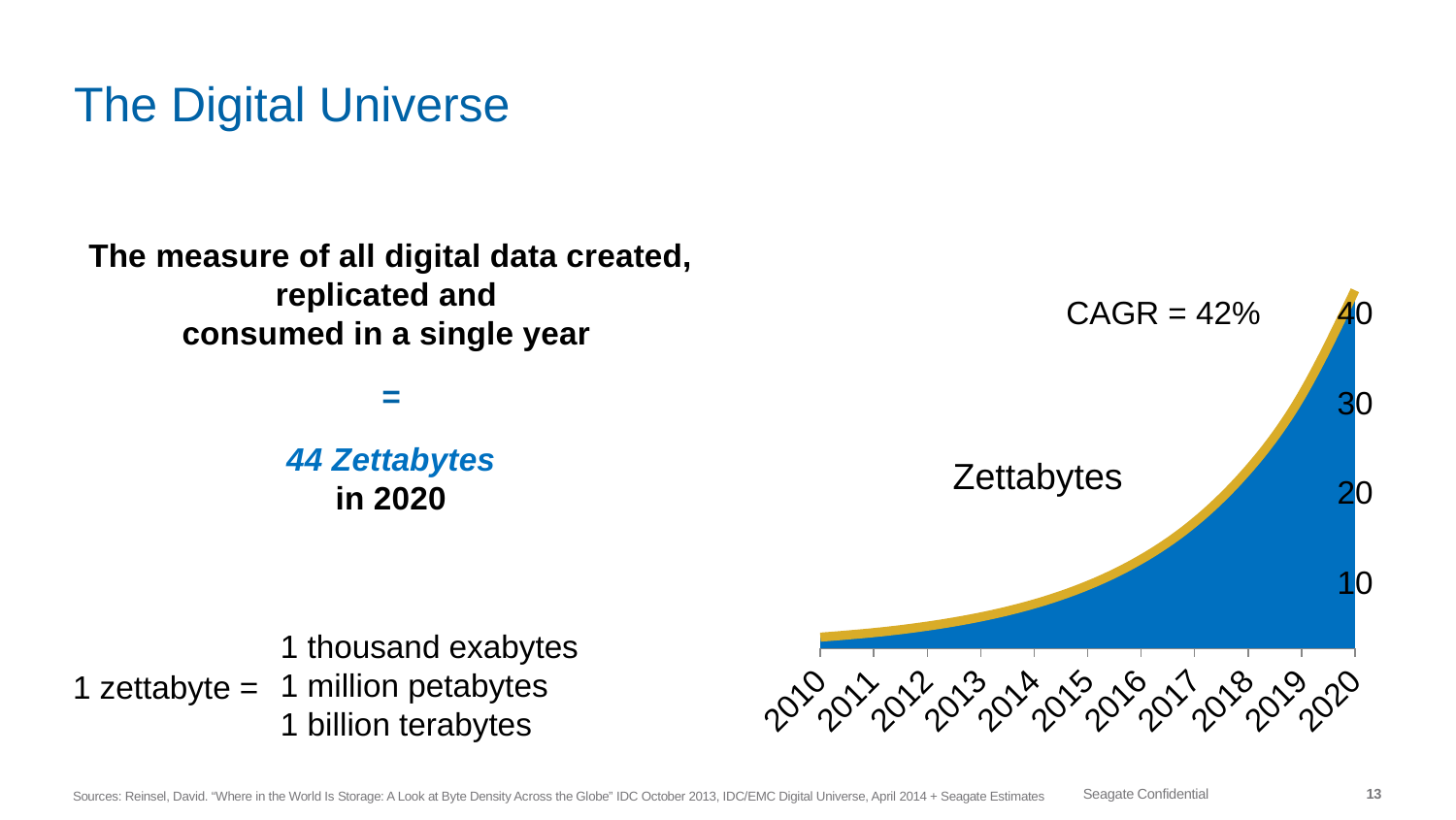
How many years are shown on the x axis of the chart? 11 What CAGR is stated on the chart? 42% Is the value for 2020 greater or less than 30? greater Do the values in the chart rise or fall from 2010 to 2020? rise Which year has the lowest value in the chart? 2010 What kind of chart is shown on the slide? area chart Is the value for 2015 greater or less than 10? less What unit is the chart's y axis labelled with? Zettabytes Is the value for 2013 greater or less than 10? less Which year has the larger value, 2014 or 2019? 2019 Which year has the highest value in the chart? 2020